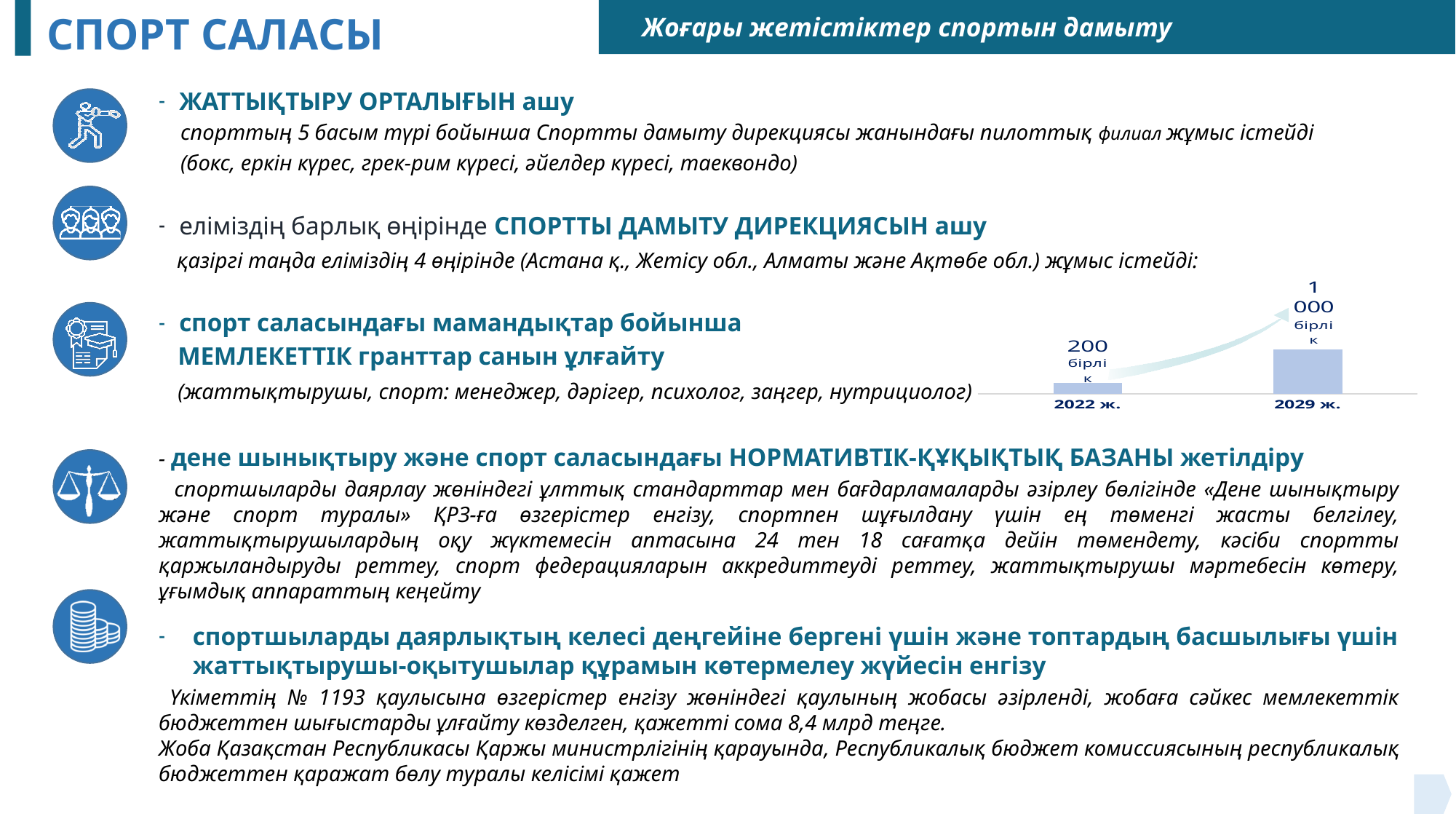
By how much does the value for 2029 ж. exceed the value for 2022 ж. in the bar chart? 800 бірлік Which year has the lower value in the bar chart? 2022 ж. Which year has the higher value in the bar chart? 2029 ж. How many bars are plotted in the chart? 2 Do the values in the chart rise or fall from 2022 ж. to 2029 ж.? rise What are the two category labels on the x axis of the chart? 2022 ж. and 2029 ж. What is the value shown for 2029 ж. in the bar chart? 1 000 бірлік What is the value shown for 2022 ж. in the bar chart? 200 бірлік Is the value for 2029 ж. larger or smaller than the value for 2022 ж.? larger What kind of chart is shown on the slide? bar chart